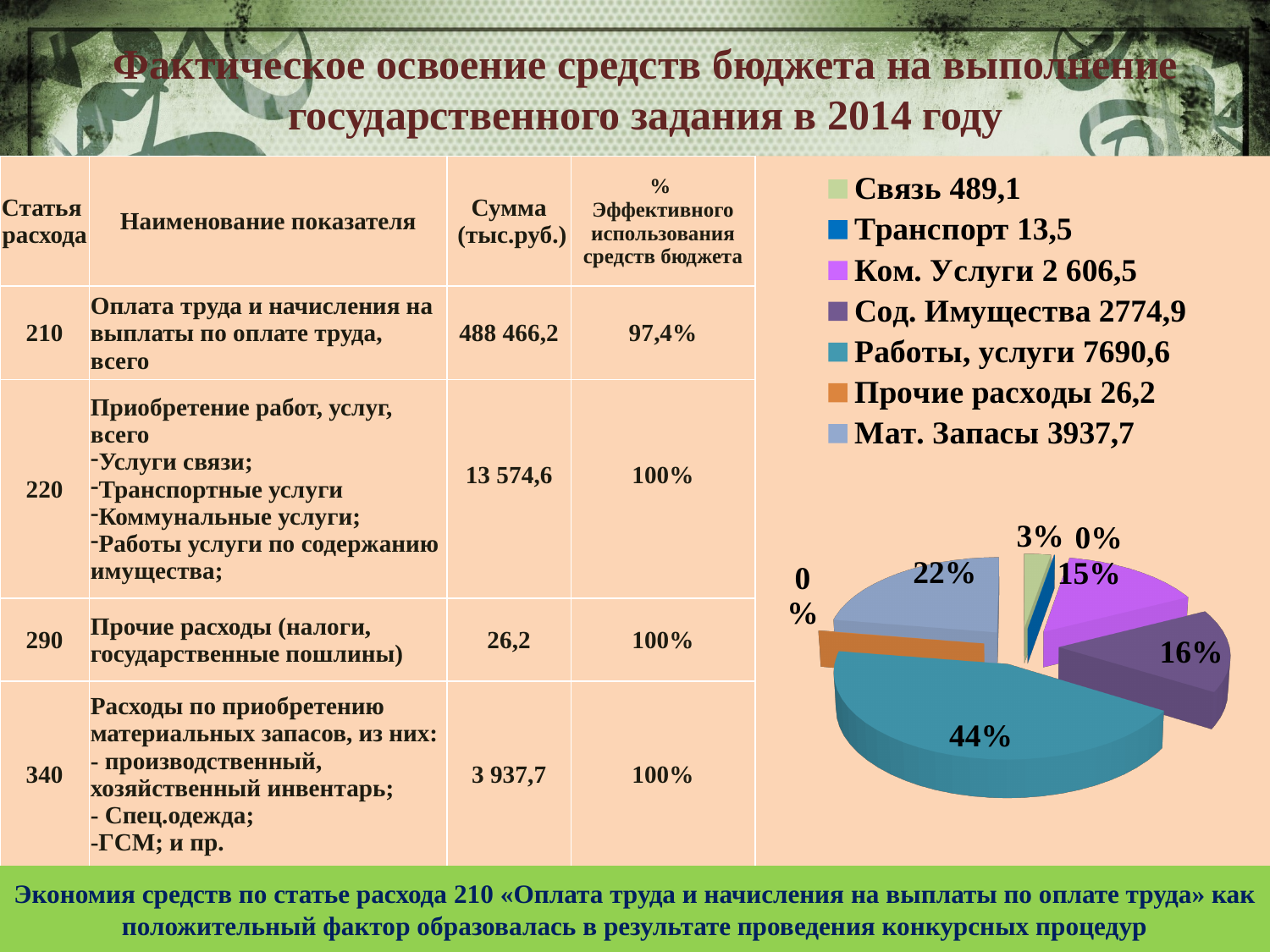
What value is shown in the legend for Связь? 489,1 What value is shown in the legend for Работы, услуги? 7690,6 What percentage share of the pie does Мат. Запасы have? 22% What is the difference between the legend values for Прочие расходы and Транспорт? 12,7 What is the difference between the legend values for Мат. Запасы and Сод. Имущества? 1162,8 How many categories does the legend of the pie chart list? 7 Which is larger in the pie chart: Сод. Имущества or Ком. Услуги? Сод. Имущества Which category has the smallest value in the pie chart legend? Транспорт What value is shown in the legend for Ком. Услуги? 2 606,5 What percentage share of the pie does Работы, услуги have? 44% Which category has the largest share of the pie chart? Работы, услуги What kind of chart is shown on the right side of the slide? pie chart